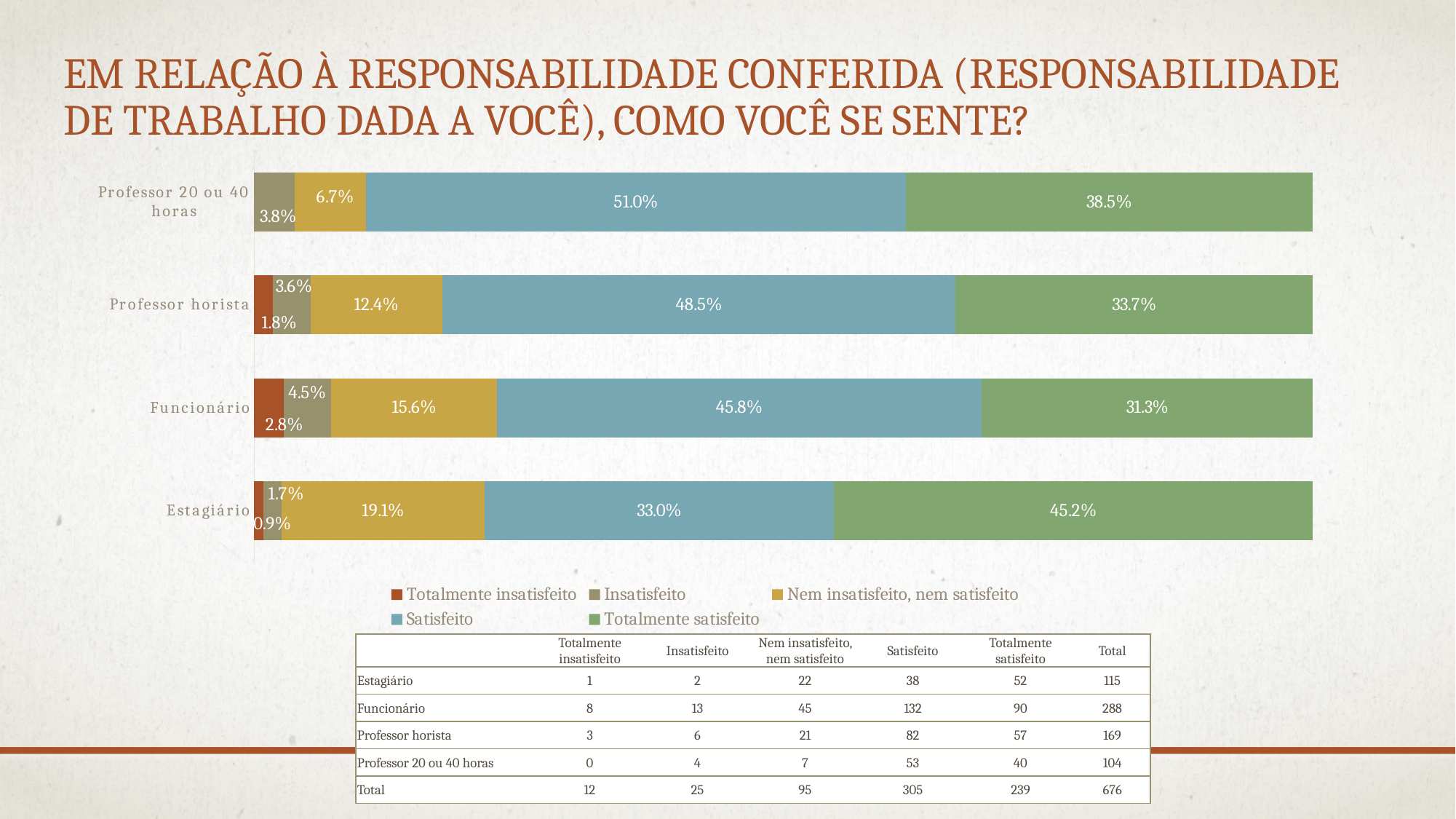
What kind of chart is shown on the slide? Stacked bar chart Which series is shown in green in the legend? Totalmente satisfeito What is the value of "Satisfeito" for "Professor 20 ou 40 horas"? 51.0% Which category has the highest value for "Totalmente satisfeito"? Estagiário What is the value of "Nem insatisfeito, nem satisfeito" for "Funcionário"? 15.6% Which is larger: "Nem insatisfeito, nem satisfeito" for "Estagiário" or for "Professor horista"? Estagiário What is the value of "Totalmente insatisfeito" for "Professor horista"? 1.8% What is the value of "Totalmente satisfeito" for "Estagiário"? 45.2% How many series does the legend list? 5 How many categories are shown on the chart? 4 What is the difference between the "Satisfeito" values for "Professor 20 ou 40 horas" and "Estagiário"? 18.0% Which category has the lowest value for "Satisfeito"? Estagiário